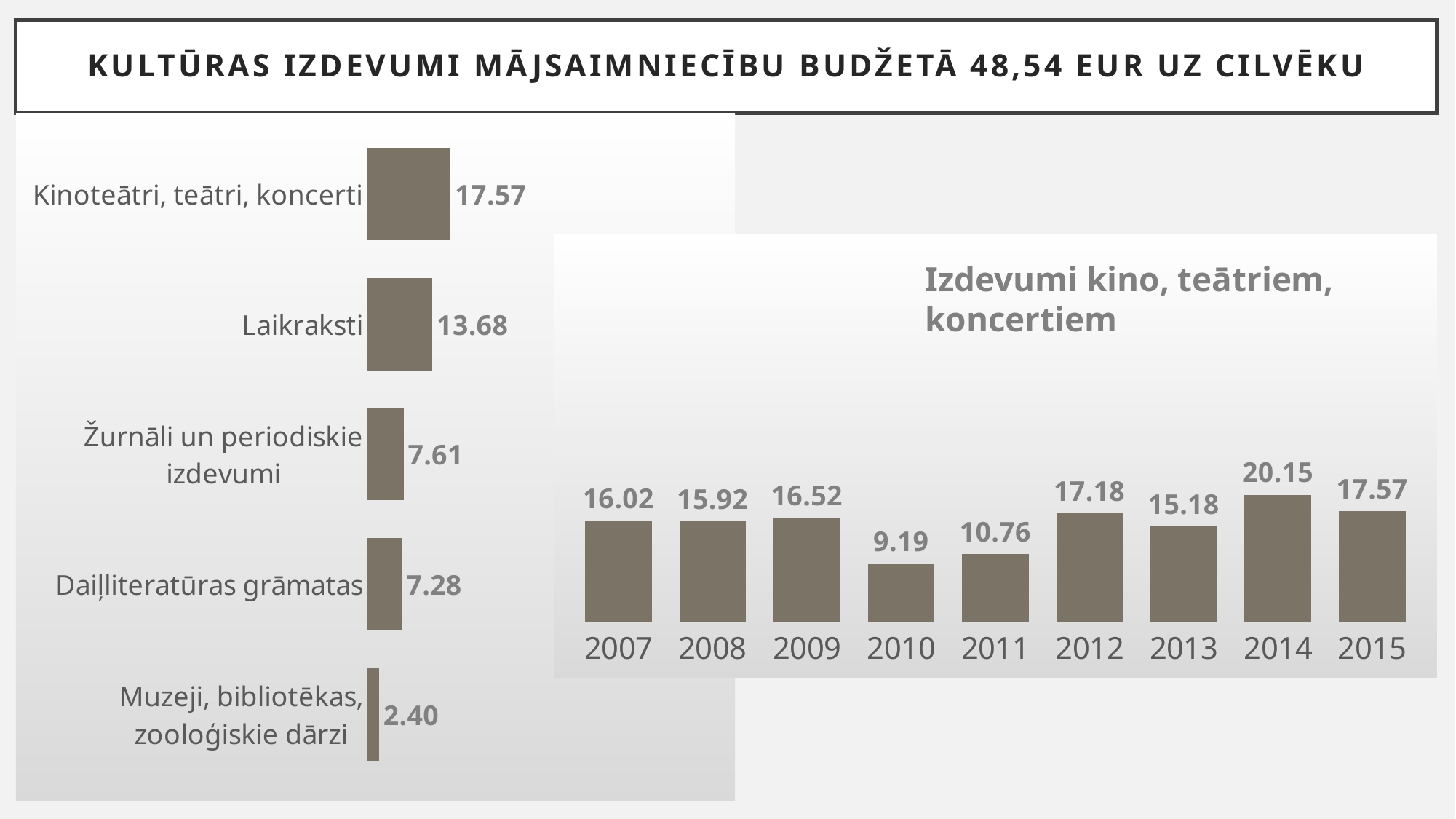
In the chart titled 'Izdevumi kino, teātriem, koncertiem', how many years are shown? 9 In the left chart, how many categories are shown? 5 In the chart titled 'Izdevumi kino, teātriem, koncertiem', which year has the lowest value? 2010 In the left chart, which is larger: Žurnāli un periodiskie izdevumi or Daiļliteratūras grāmatas? Žurnāli un periodiskie izdevumi In the left chart, what is the difference between Kinoteātri, teātri, koncerti and Laikraksti? 3.89 In the chart titled 'Izdevumi kino, teātriem, koncertiem', what is the difference between 2014 and 2015? 2.58 In the chart titled 'Izdevumi kino, teātriem, koncertiem', which year has the highest value? 2014 In the left chart, which category has the lowest value? Muzeji, bibliotēkas, zooloģiskie dārzi What type of chart is the chart titled 'Izdevumi kino, teātriem, koncertiem'? bar chart In the left chart, which category has the highest value? Kinoteātri, teātri, koncerti In the chart titled 'Izdevumi kino, teātriem, koncertiem', what is the value for 2010? 9.19 In the left chart, what is the value for Laikraksti? 13.68